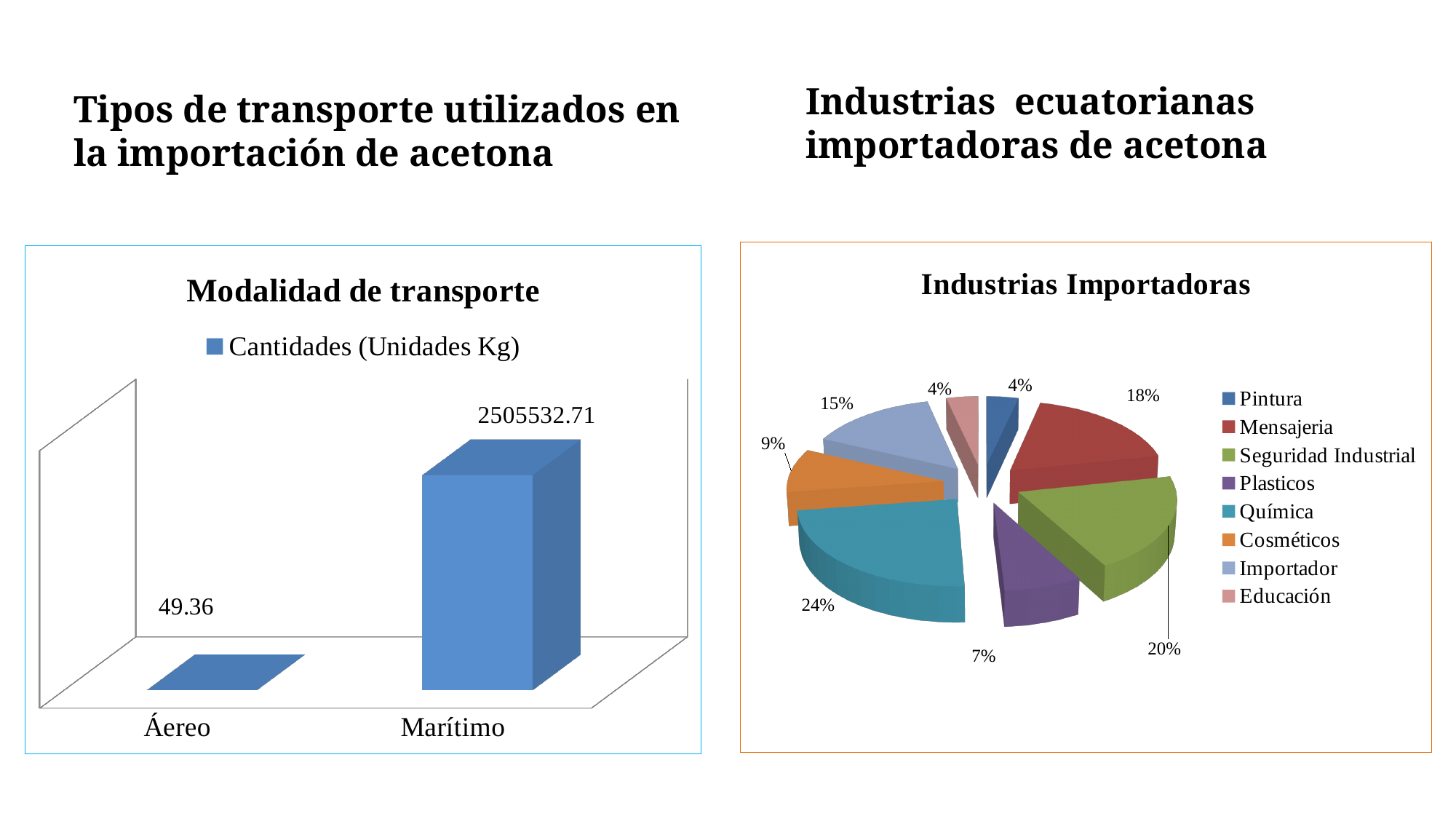
What type of chart is the 'Modalidad de transporte' chart? bar chart In the 'Industrias Importadoras' chart, which industry has the largest share? Química In the 'Modalidad de transporte' chart, what series does the legend list? Cantidades (Unidades Kg) In the 'Modalidad de transporte' chart, what is the difference between the Marítimo and Áereo values? 2505483.35 In the 'Modalidad de transporte' chart, what is the value for Áereo? 49.36 In the 'Modalidad de transporte' chart, which category has the highest value? Marítimo In the 'Industrias Importadoras' chart, which is larger, Mensajeria or Cosméticos? Mensajeria In the 'Industrias Importadoras' chart, what share does Seguridad Industrial have? 20% In the 'Industrias Importadoras' chart, what share does Química have? 24% In the 'Modalidad de transporte' chart, what is the value for Marítimo? 2505532.71 What type of chart is the 'Industrias Importadoras' chart? pie chart In the 'Industrias Importadoras' chart, how many industries does the legend list? 8